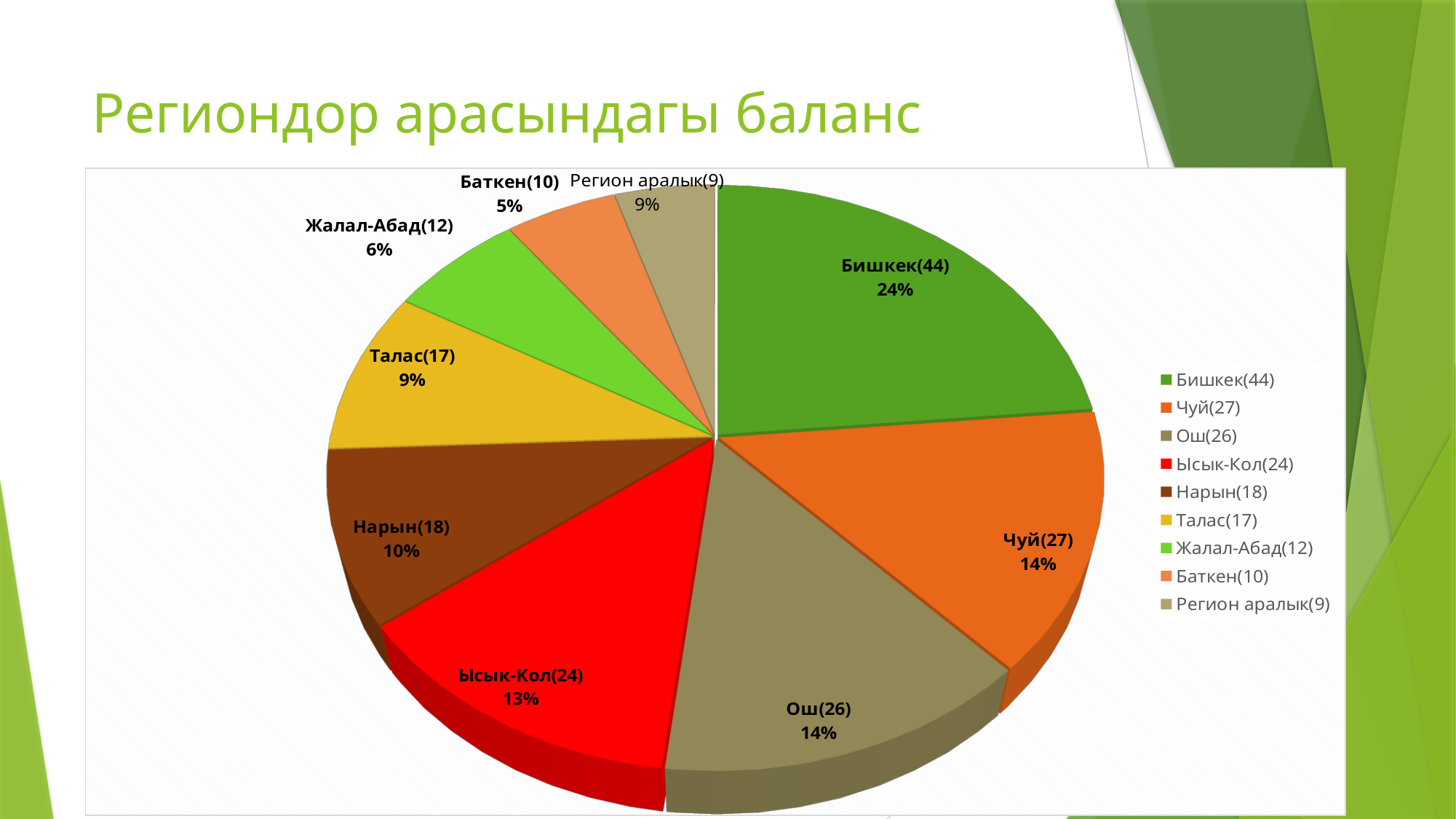
Which slice has the smallest percentage label on the pie? Баткен(10), 5% What kind of chart is shown on the slide? Pie chart What is the difference between the counts in the labels for Бишкек(44) and Чуй(27)? 17 What share of the pie does Ысык-Кол(24) have? 13% What percentage is shown for Нарын(18)? 10% What share of the pie does Бишкек(44) have? 24% Which has the larger count in its label, Нарын or Талас? Нарын(18) What percentage is shown for Талас(17)? 9% Which region has the largest slice of the pie? Бишкек(44) What colour is the Ысык-Кол(24) slice? Red What is the title of the slide? Региондор арасындагы баланс How many slices does the pie chart have? 9